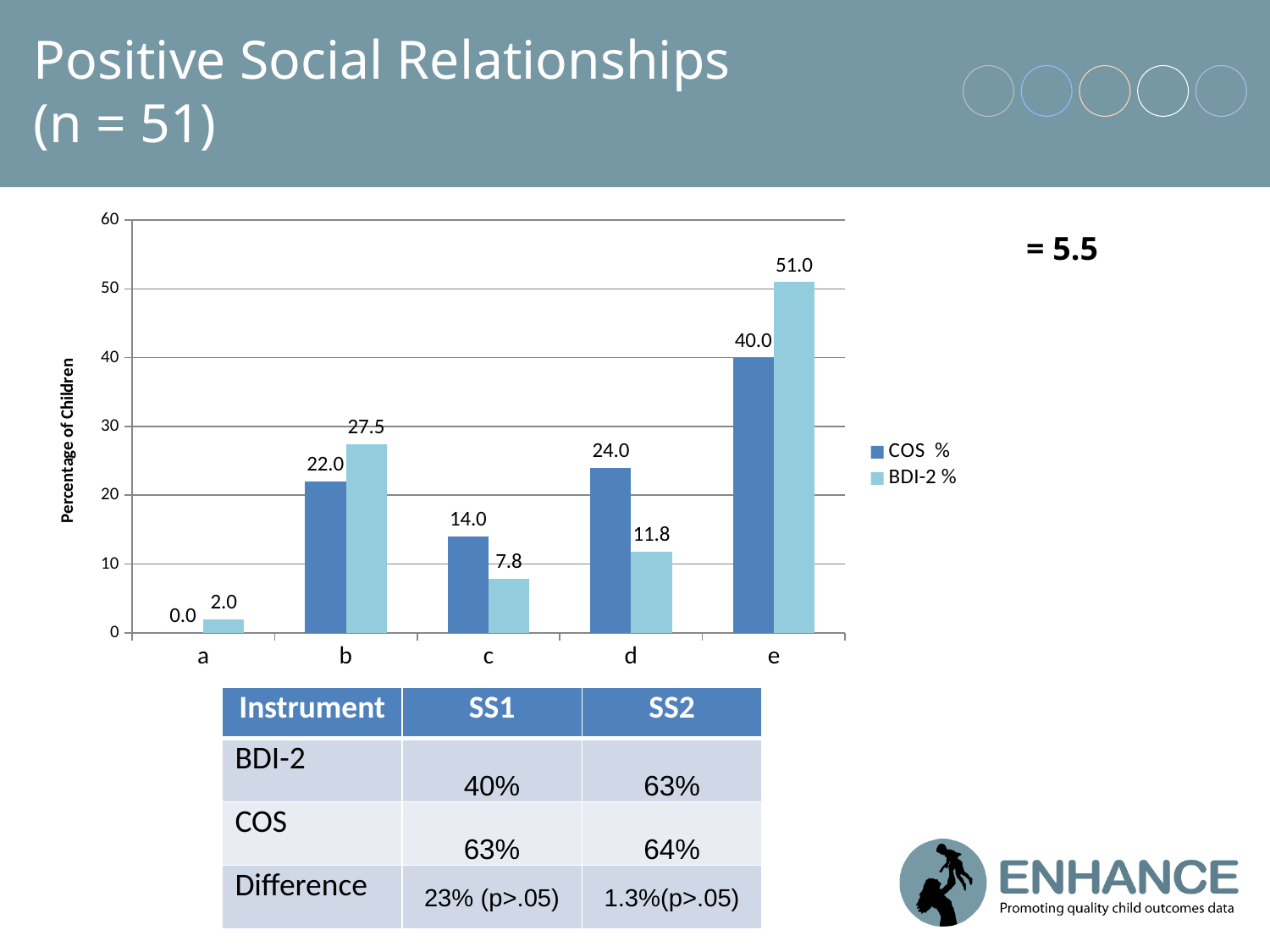
What is the difference between the BDI-2 % and COS % values for category e? 11.0 How many categories are shown on the x axis? 5 What is the COS % value for category e? 40.0 Which category has the highest BDI-2 % value? e What kind of chart is shown on the slide? bar chart Which category has the lowest COS % value? a What is the difference between the COS % and BDI-2 % values for category d? 12.2 What is the BDI-2 % value for category a? 2.0 For category b, which series has the larger value, COS % or BDI-2 %? BDI-2 % How many series does the legend list? 2 What is the BDI-2 % value for category c? 7.8 What is the label of the y axis? Percentage of Children